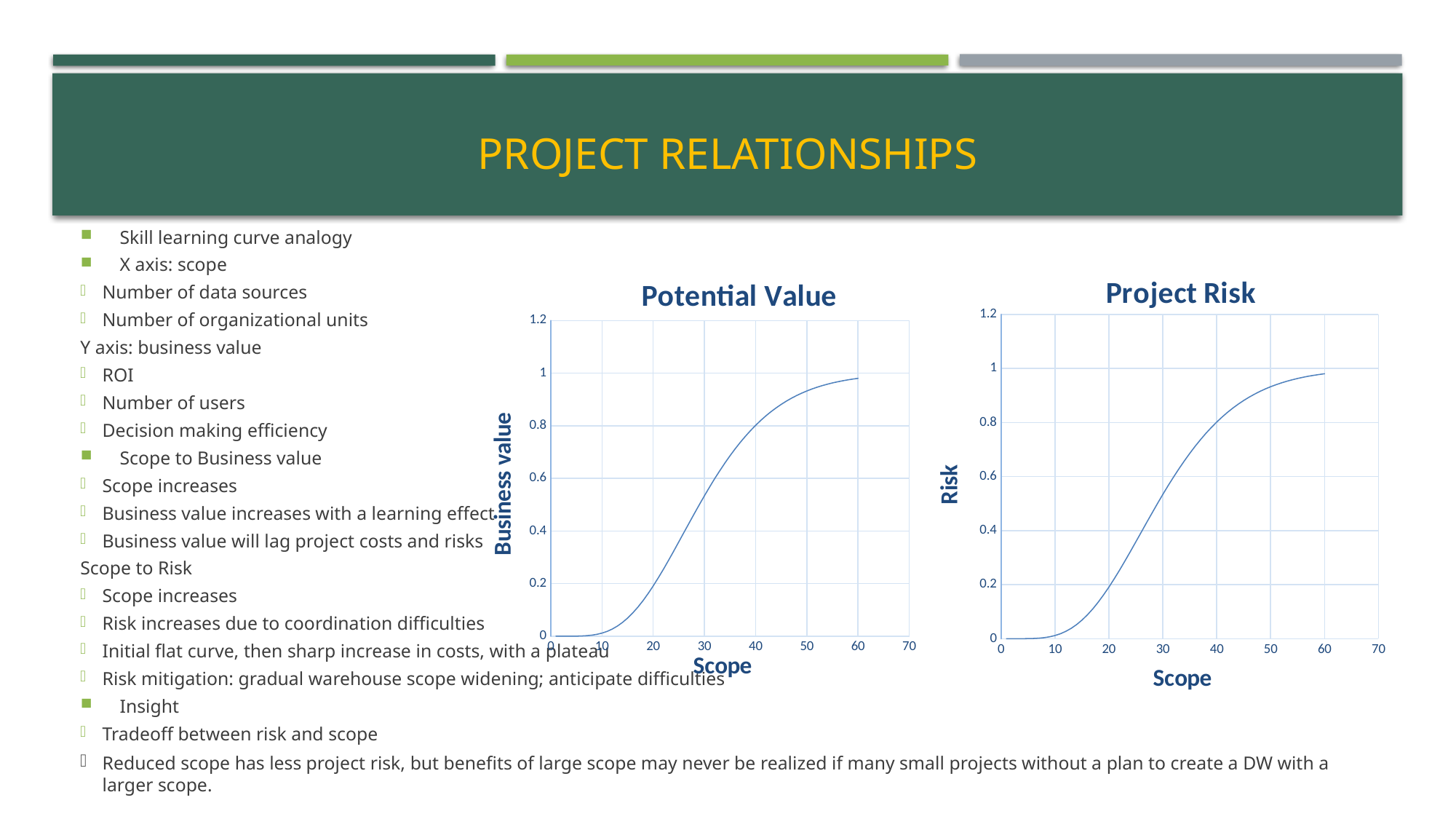
In the "Potential Value" chart, does business value rise or fall as scope increases along the x axis? rise What is the x-axis label of the "Potential Value" chart? Scope In the "Project Risk" chart, is the risk at a scope of 50 greater or less than 0.8? greater What is the y-axis label of the "Project Risk" chart? Risk In the "Project Risk" chart, does risk rise or fall as scope increases along the x axis? rise In the "Potential Value" chart, is the business value at a scope of 30 greater or less than 0.4? greater What kind of chart is the "Project Risk" chart? line chart What kind of chart is the "Potential Value" chart? line chart In the "Project Risk" chart, is the risk at a scope of 60 greater or less than 1? less